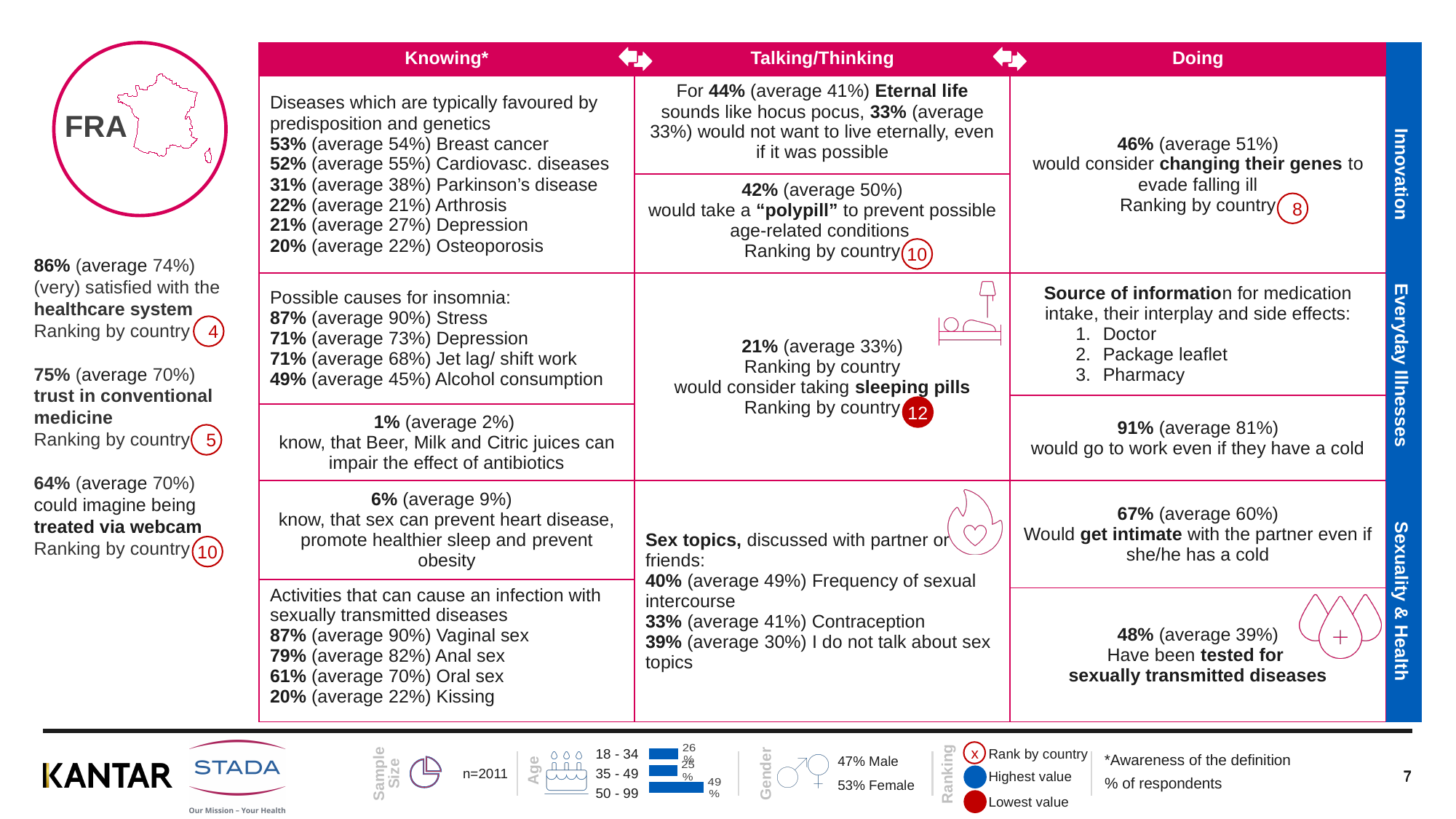
What kind of chart is the Age chart at the bottom of the slide? bar chart In the Age bar chart at the bottom of the slide, what are the labels of the three age groups? 18 - 34, 35 - 49, 50 - 99 In the Age bar chart at the bottom of the slide, which age group has the highest value? 50 - 99 In the Age bar chart at the bottom of the slide, how many age groups are shown? 3 In the Age bar chart at the bottom of the slide, which is larger: the value for 35 - 49 or the value for 50 - 99? 50 - 99 In the Age bar chart at the bottom of the slide, are the bars horizontal or vertical? horizontal In the Age bar chart at the bottom of the slide, which is larger: the value for 18 - 34 or the value for 50 - 99? 50 - 99 In the Age bar chart at the bottom of the slide, what is the value for the 50 - 99 age group? 49%